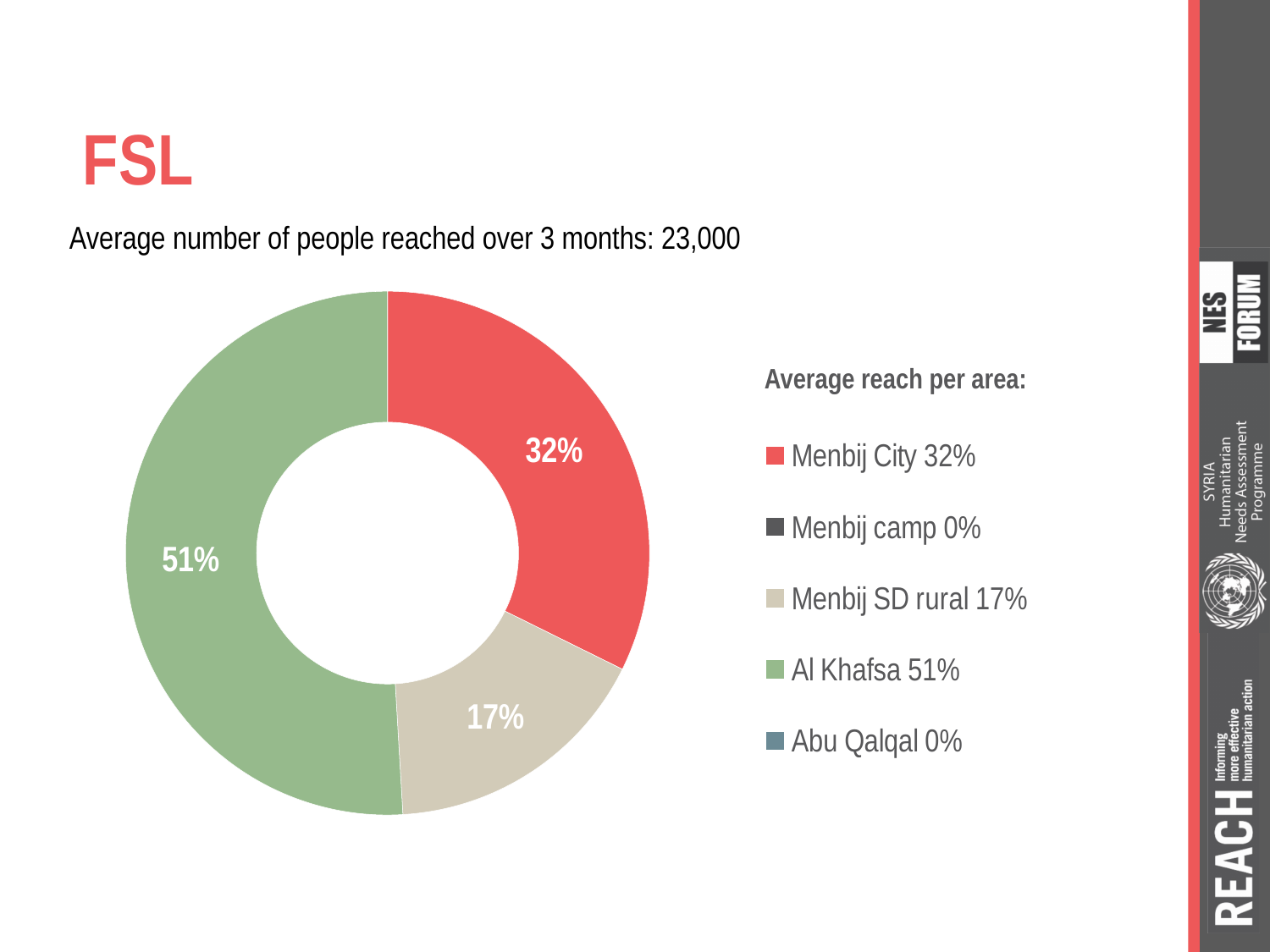
What percentage is shown for Menbij camp in the legend? 0% What kind of chart is shown on the slide? Donut (pie) chart How many areas are listed in the chart legend? 5 What is the average number of people reached over 3 months stated on the slide? 23,000 What colour is the Al Khafsa segment of the chart? Green Which area has a larger share, Menbij City or Menbij SD rural? Menbij City Which area has the largest share of the average reach? Al Khafsa What is the difference in percentage points between Al Khafsa and Menbij City? 19 percentage points What percentage is shown for Abu Qalqal in the legend? 0% What share of the average reach is Al Khafsa? 51% What share of the average reach is Menbij SD rural? 17% What share of the average reach is Menbij City? 32%